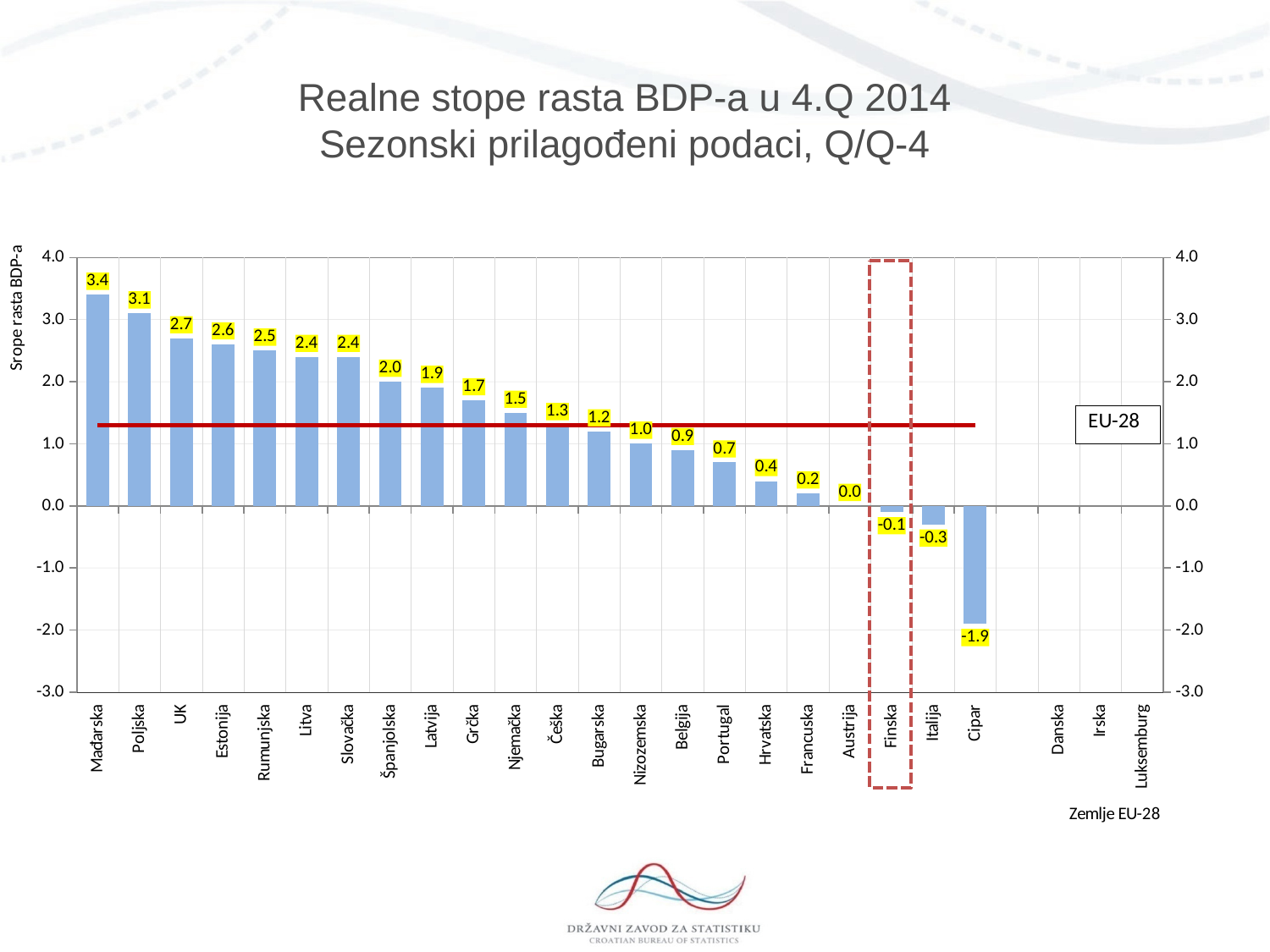
Is the value for Cipar greater or less than -1.0? less Do the bar values rise or fall from left to right along the x axis? fall Which country has the lowest value? Cipar What is the value for Cipar? -1.9 Which is larger, the value for Španjolska or the value for Grčka? Španjolska What is the difference between the values for Njemačka and Hrvatska? 1.1 What does the red horizontal line represent, according to its label? EU-28 What is the value for Hrvatska? 0.4 What kind of chart is shown on the slide? bar chart What is the value for Finska? -0.1 What is the difference between the values for Mađarska and Poljska? 0.3 Which country has the highest value? Mađarska